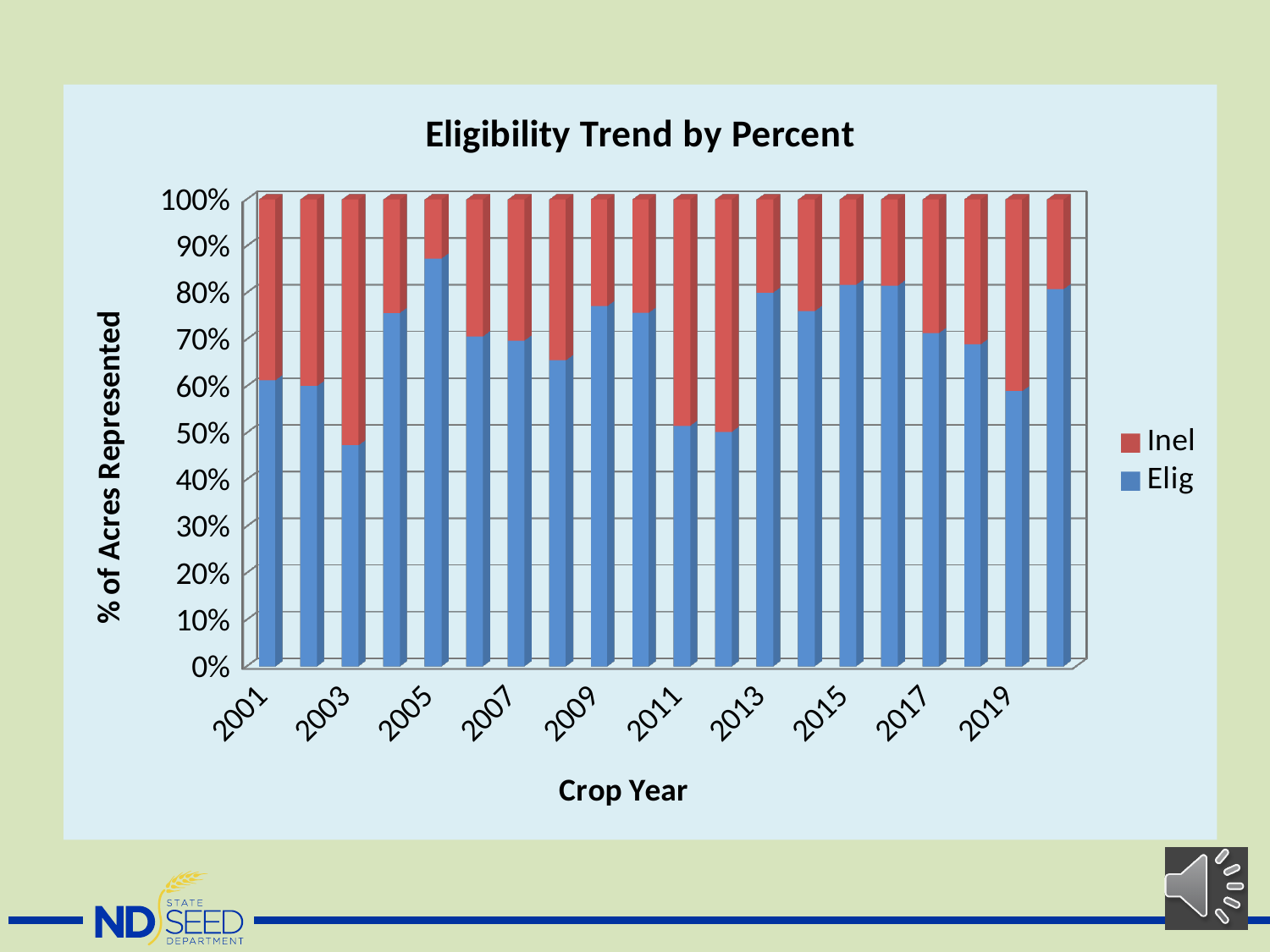
Which crop year has the highest Elig share? 2005 What kind of chart is shown on the slide? stacked bar chart What is the total of the stacked bar for 2001 (Elig plus Inel)? 100% What are the two series named in the legend? Inel and Elig Is the Elig value for 2013 greater or less than 70%? greater Which crop year has a larger Elig share, 2005 or 2003? 2005 Which crop year has the lowest Elig share? 2003 How many crop years (bars) are plotted in the chart? 20 What is the title of the chart? Eligibility Trend by Percent How many series does the legend list? 2 Is the Elig value for 2003 greater or less than 50%? less Is the Elig value for 2005 greater or less than 80%? greater